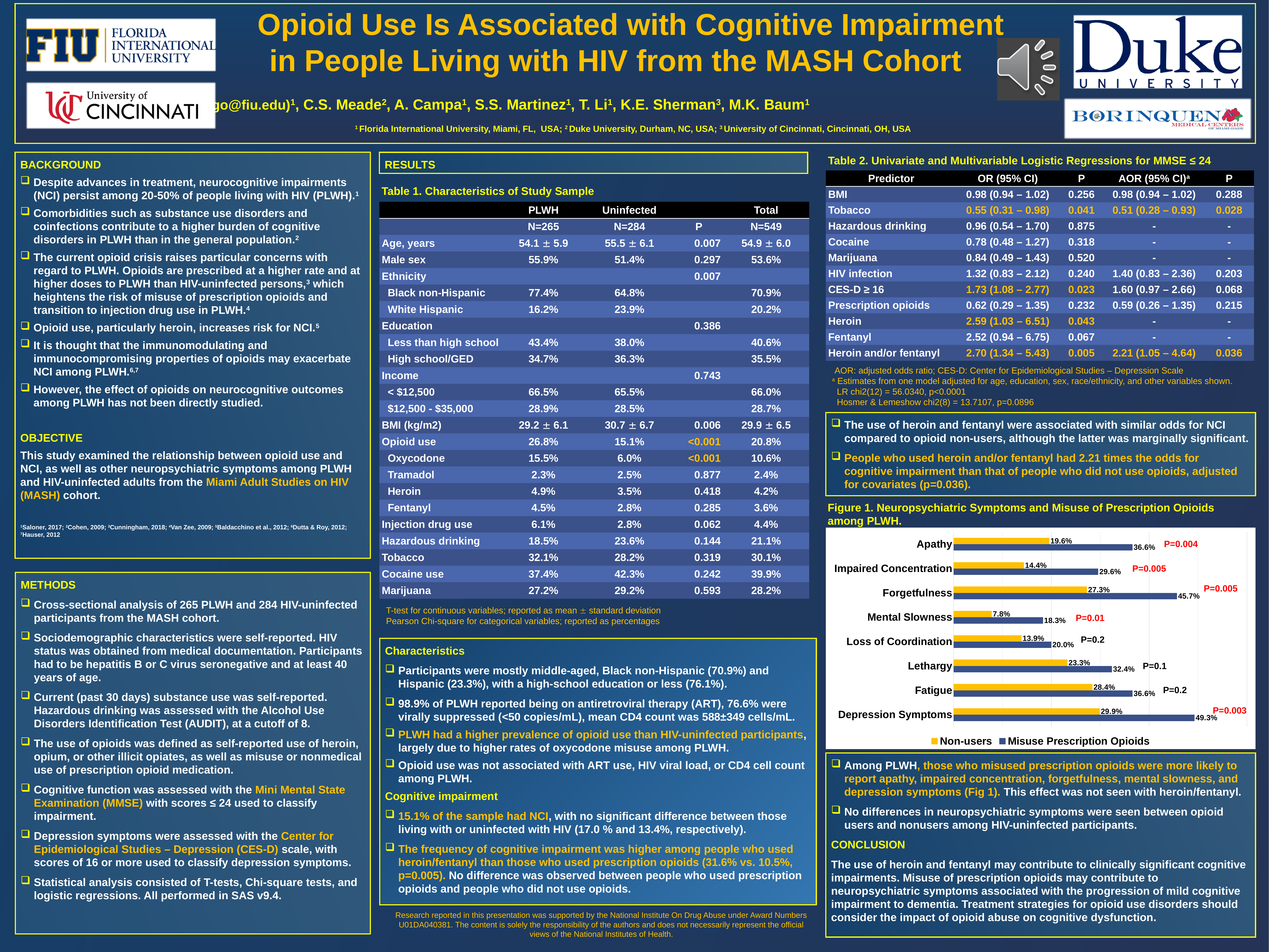
How many series does the legend of Figure 1 list? 2 In Figure 1, what is the difference between Misuse Prescription Opioids and Non-users for Apathy? 17.0% In Figure 1, what is the value for Non-users for Forgetfulness? 27.3% What kind of chart is Figure 1? Bar chart In Figure 1, what is the value for Misuse Prescription Opioids for Depression Symptoms? 49.3% In Figure 1, which symptom has the highest value for Misuse Prescription Opioids? Depression Symptoms In Figure 1, what is the difference between Misuse Prescription Opioids and Non-users for Depression Symptoms? 19.4% How many symptom categories are shown in Figure 1? 8 In Figure 1, what is the value for Misuse Prescription Opioids for Mental Slowness? 18.3% In Figure 1, which is larger for Lethargy: the Non-users value or the Misuse Prescription Opioids value? Misuse Prescription Opioids In Figure 1, which symptom has the lowest value for Non-users? Mental Slowness In Figure 1, which colour represents Non-users? Yellow